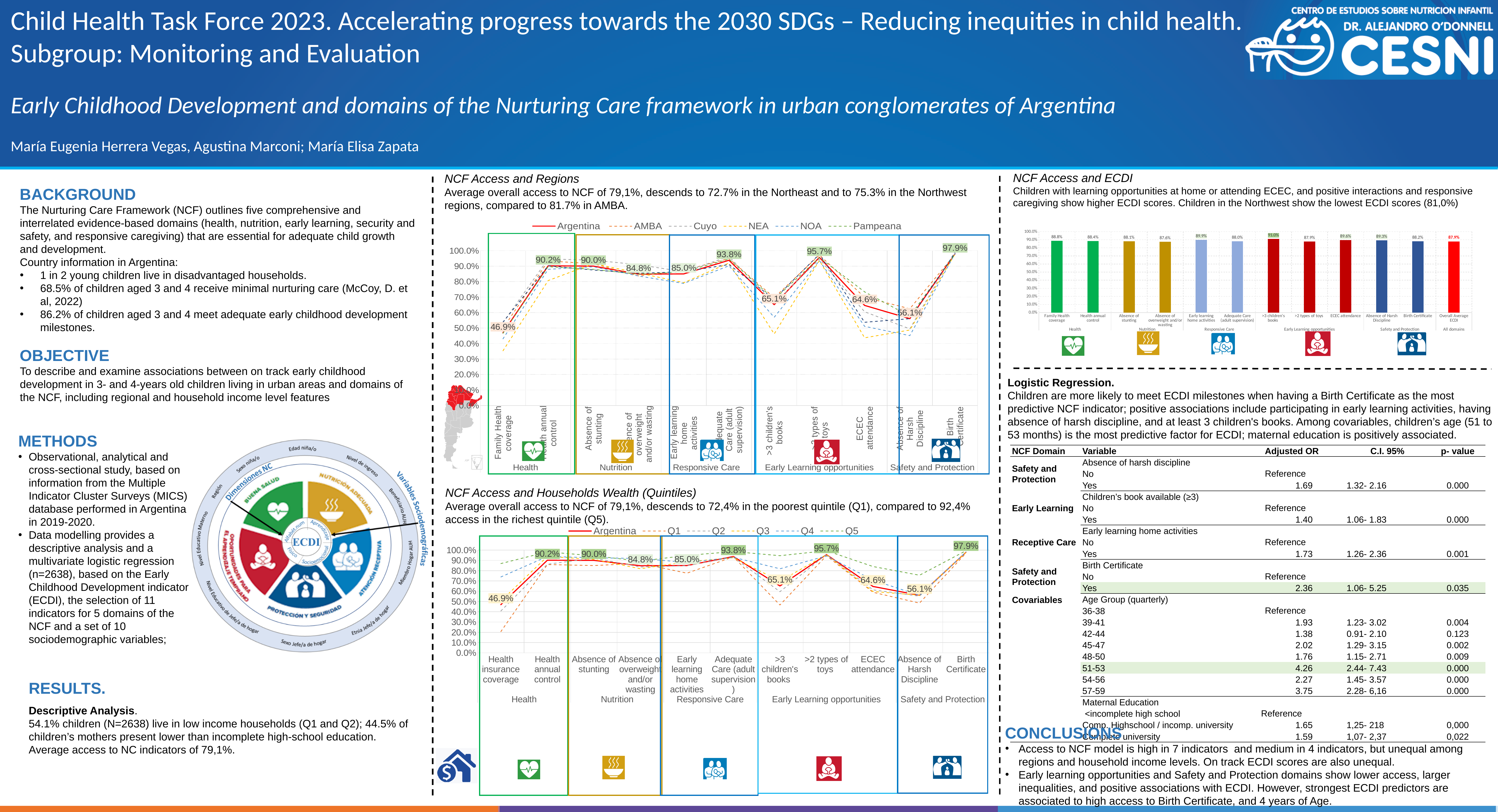
In the 'NCF Access and Regions' chart, which indicator has the highest Argentina value? Birth Certificate In the 'NCF Access and Households Wealth (Quintiles)' chart, which is larger for Argentina: Absence of stunting or Absence of overweight and/or wasting? Absence of stunting In the 'NCF Access and Households Wealth (Quintiles)' chart, what is the Argentina value for ECEC attendance? 64.6% In the 'NCF Access and Regions' chart, which indicator has the lowest Argentina value? Family Health coverage In the 'NCF Access and Regions' chart, how many series does the legend list? 6 In the 'NCF Access and ECDI' bar chart, how many bars are plotted? 12 In the 'NCF Access and ECDI' bar chart, which category has the highest value? >3 children's books In the 'NCF Access and Regions' chart, what is the Argentina value for Birth Certificate? 97.9% In the 'NCF Access and ECDI' bar chart, what is the value for >3 children's books? 91.0% In the 'NCF Access and Households Wealth (Quintiles)' chart, what is the difference between the Argentina values for >2 types of toys and >3 children's books? 30.6% In the 'NCF Access and Households Wealth (Quintiles)' chart, what kind of chart is shown? Line chart In the 'NCF Access and Regions' chart, what is the Argentina value for Family Health coverage? 46.9%